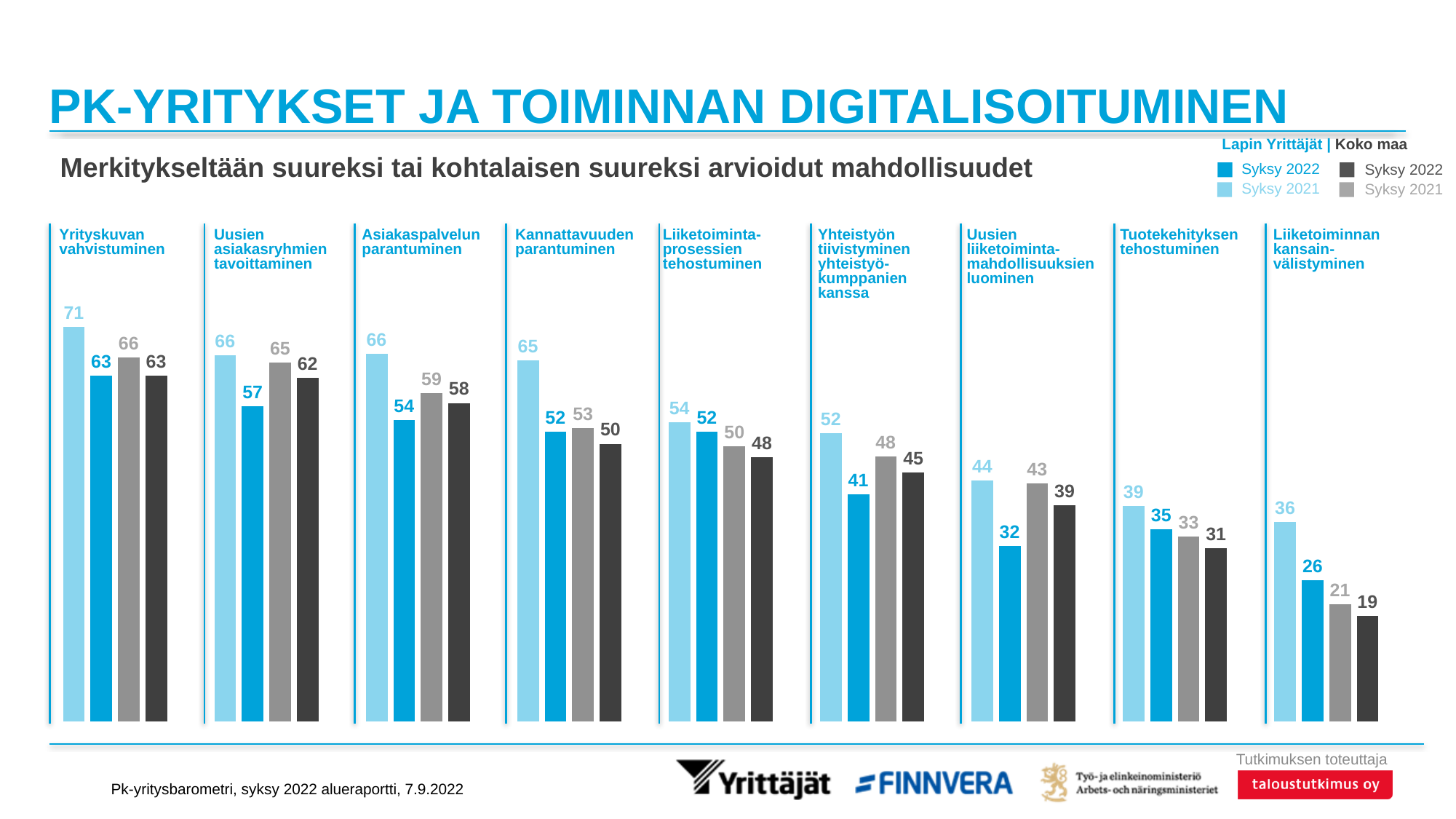
What is the Lapin Yrittäjät Syksy 2021 value for Liiketoiminnan kansainvälistyminen? 36 Which category has the lowest Koko maa Syksy 2022 value? Liiketoiminnan kansainvälistyminen Which category has the highest Lapin Yrittäjät Syksy 2021 value? Yrityskuvan vahvistuminen What is the difference between the Lapin Yrittäjät Syksy 2021 and Syksy 2022 values for Uusien liiketoimintamahdollisuuksien luominen? 12 How many series does the legend list? 4 Do the Koko maa Syksy 2022 values rise or fall from left to right across the categories? Fall How many categories are shown in the chart? 9 What is the Lapin Yrittäjät Syksy 2022 value for Yrityskuvan vahvistuminen? 63 What kind of chart is shown on the slide? Bar chart Which colour represents Lapin Yrittäjät Syksy 2022 in the legend? Blue What is the Koko maa Syksy 2021 value for Asiakaspalvelun parantuminen? 59 For Kannattavuuden parantuminen, which is larger: the Lapin Yrittäjät Syksy 2022 value or the Koko maa Syksy 2021 value? Koko maa Syksy 2021